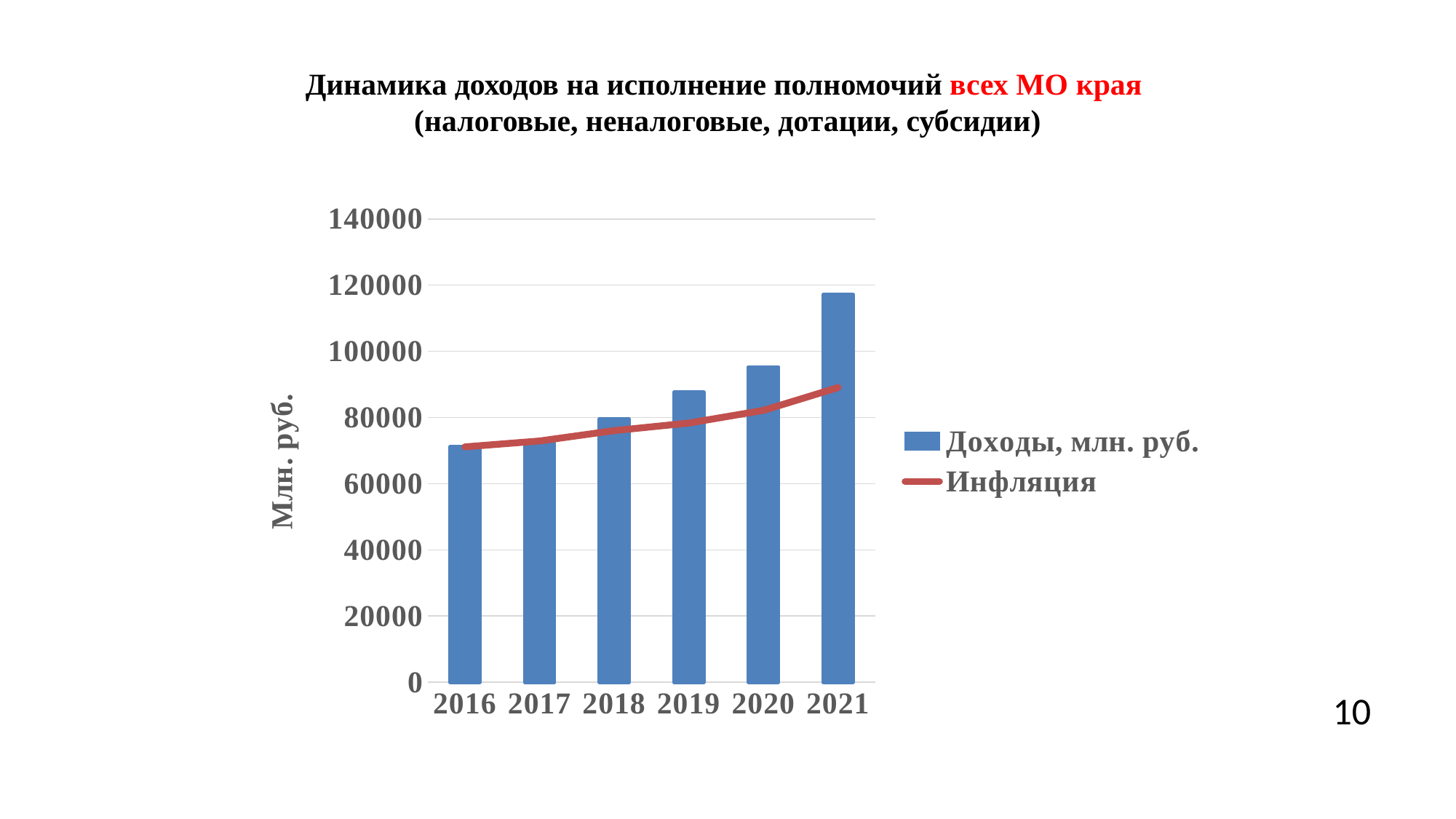
Do the values for Доходы, млн. руб. rise or fall from 2016 to 2021? Rise Is the value for Доходы, млн. руб. in 2021 greater or less than 100000? greater Which is larger, the value for Доходы, млн. руб. in 2020 or in 2021? 2021 What kind of chart is shown on the slide? A bar chart with a line What colour is the Инфляция line in the chart? Red What is the label of the vertical axis? Млн. руб. Is the value for Доходы, млн. руб. in 2016 greater or less than 60000? greater How many series does the legend list? 2 Is the value for Доходы, млн. руб. in 2020 greater or less than 100000? less Which year has the highest value for Доходы, млн. руб.? 2021 How many years are shown on the x axis of the chart? 6